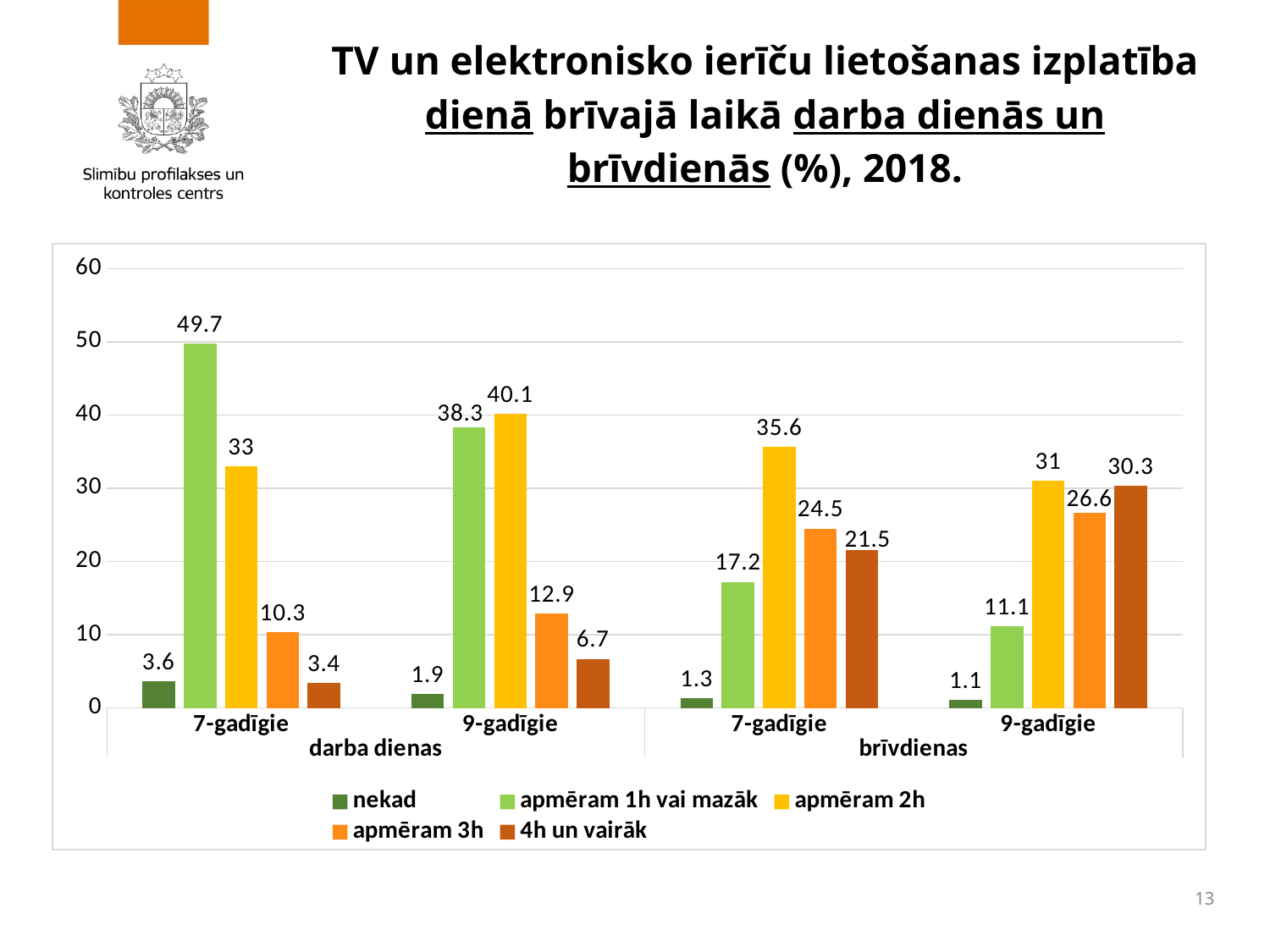
Which series has the highest value for 9-gadīgie on brīvdienas? apmēram 2h What is the difference between the 'apmēram 3h' values for 7-gadīgie on brīvdienas and on darba dienas? 14.2 What is the value for 'apmēram 2h' for 9-gadīgie on darba dienas? 40.1 Which series has the lowest value for 7-gadīgie on darba dienas? 4h un vairāk What colour are the bars for the 'apmēram 2h' series? yellow How many category groups are shown on the x axis? 4 What is the value for '4h un vairāk' for 7-gadīgie on brīvdienas? 21.5 What type of chart is shown on the slide? bar chart What is the value for 'apmēram 1h vai mazāk' for 7-gadīgie on darba dienas? 49.7 How many series does the legend list? 5 What is the value for 'nekad' for 9-gadīgie on brīvdienas? 1.1 Which is larger for 9-gadīgie on darba dienas: 'apmēram 1h vai mazāk' or 'apmēram 2h'? apmēram 2h